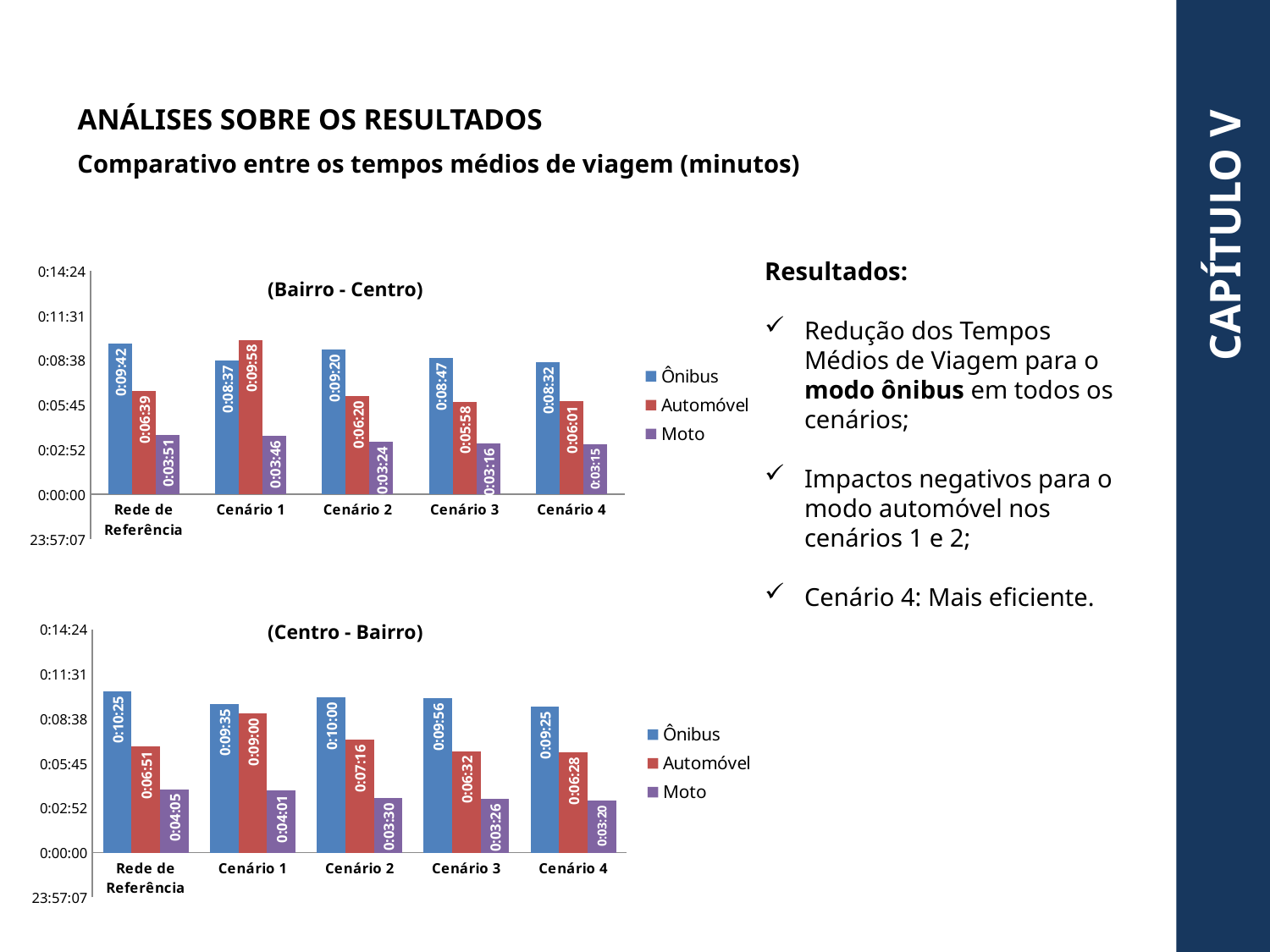
In the (Bairro - Centro) chart, which is larger in Cenário 1: the Ônibus value or the Automóvel value? Automóvel How many series does the legend of the (Bairro - Centro) chart list? 3 In the (Centro - Bairro) chart, what is the value for Ônibus in Cenário 2? 0:10:00 In the (Bairro - Centro) chart, which category has the highest Automóvel value? Cenário 1 In the (Bairro - Centro) chart, do the Moto values rise or fall from Rede de Referência to Cenário 4? Fall In the (Bairro - Centro) chart, what is the difference between the Ônibus value for Rede de Referência and for Cenário 4? 0:01:10 In the (Bairro - Centro) chart, what is the value for Ônibus in Cenário 4? 0:08:32 What type of chart is the (Centro - Bairro) chart? Bar chart How many categories are shown on the x axis of the (Centro - Bairro) chart? 5 In the (Centro - Bairro) chart, what is the value for Moto in Rede de Referência? 0:04:05 In the (Bairro - Centro) chart, what is the value for Automóvel in Cenário 1? 0:09:58 In the (Centro - Bairro) chart, which category has the lowest Moto value? Cenário 4